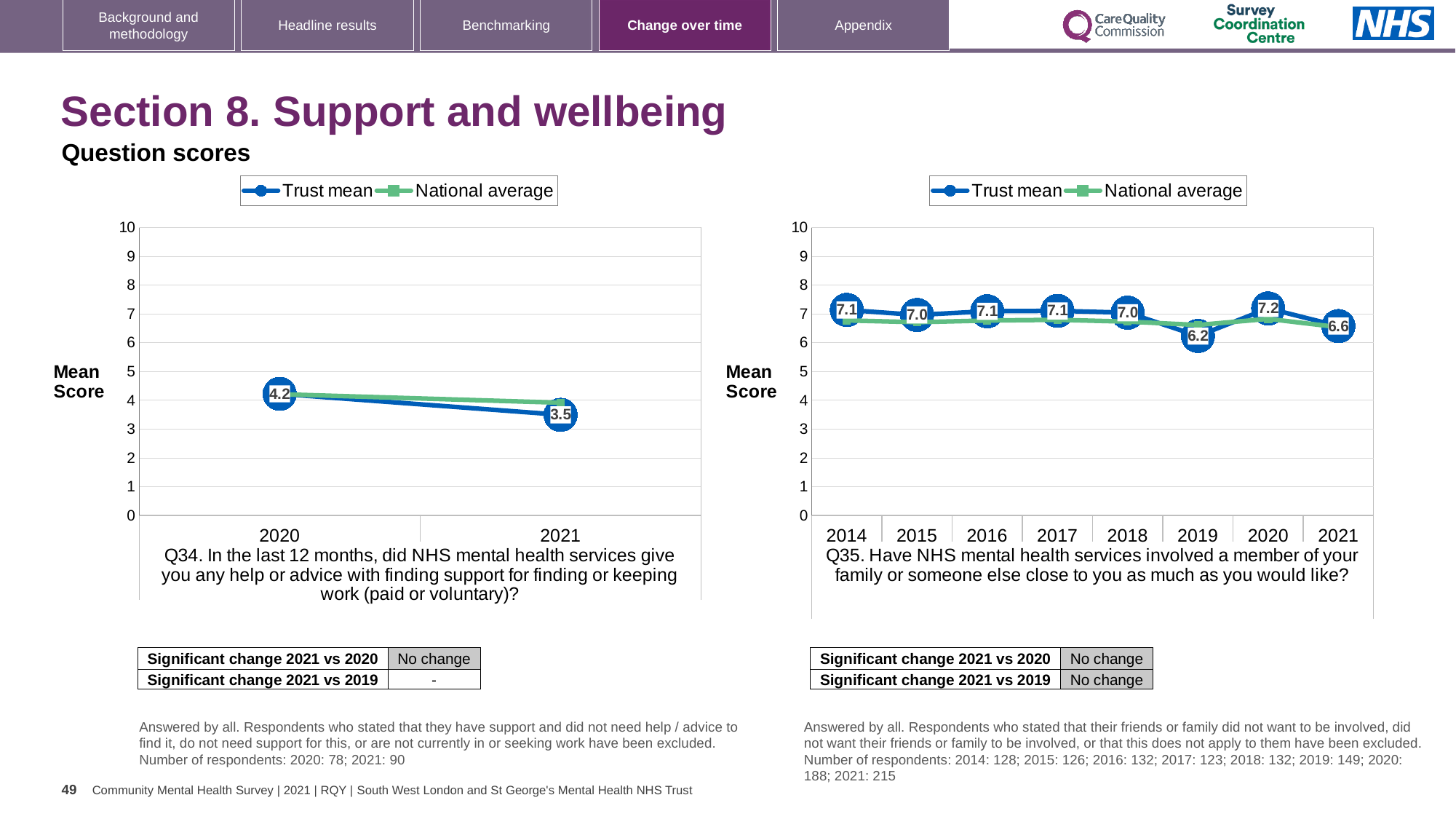
On the right chart (Q35), which year has the lowest Trust mean? 2019 On the right chart (Q35), which year has the highest Trust mean? 2020 On the right chart (Q35), what is the Trust mean for 2020? 7.2 On the left chart (Q34), what is the Trust mean for 2021? 3.5 On the right chart (Q35), what is the Trust mean for 2019? 6.2 On the right chart (Q35), is the Trust mean for 2021 greater or less than 7? less How many series does the legend of the left chart (Q34) list? 2 On the left chart (Q34), does the Trust mean rise or fall from 2020 to 2021? fall On the left chart (Q34), by how much did the Trust mean fall from 2020 to 2021? 0.7 On the right chart (Q35), how many years are plotted on the x axis? 8 On the right chart (Q35), what is the difference between the Trust mean in 2020 and in 2021? 0.6 On the left chart (Q34), what is the Trust mean for 2020? 4.2